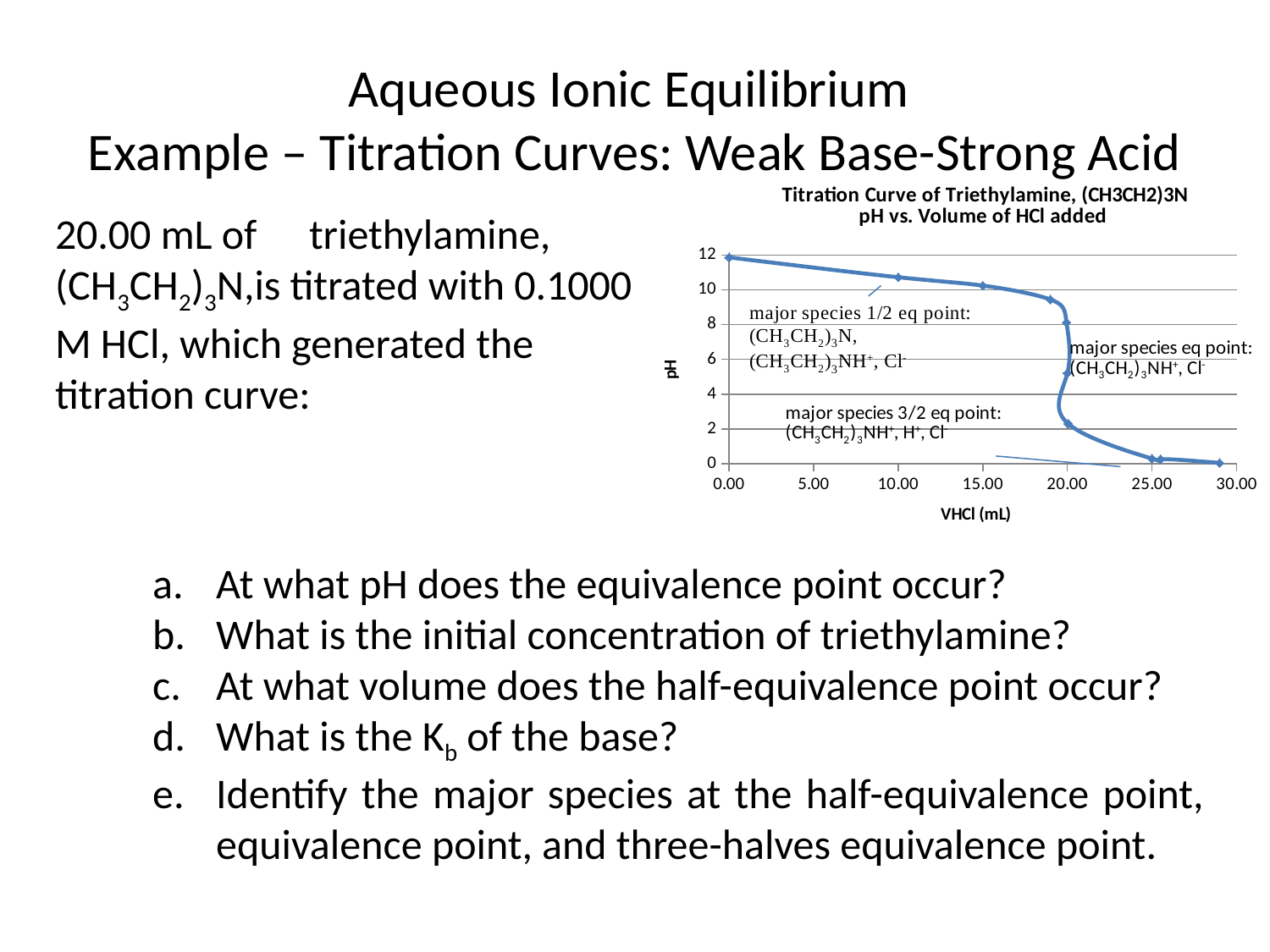
At which volume of HCl added on the x axis is the pH highest? 0.00 mL Does the pH rise or fall as the volume of HCl added increases? fall What kind of chart is shown on the slide? line chart What is the highest value shown on the pH axis? 12 Is the pH at 15.00 mL of HCl added greater or less than 8? greater Is the pH at 25.00 mL of HCl added greater or less than 2? less Which has the higher pH: 10.00 mL of HCl added or 25.00 mL of HCl added? 10.00 mL What is the label of the x axis of the chart? VHCl (mL) Is the pH at 0.00 mL of HCl added greater or less than 10? greater What is the title of the chart? Titration Curve of Triethylamine, (CH3CH2)3N pH vs. Volume of HCl added